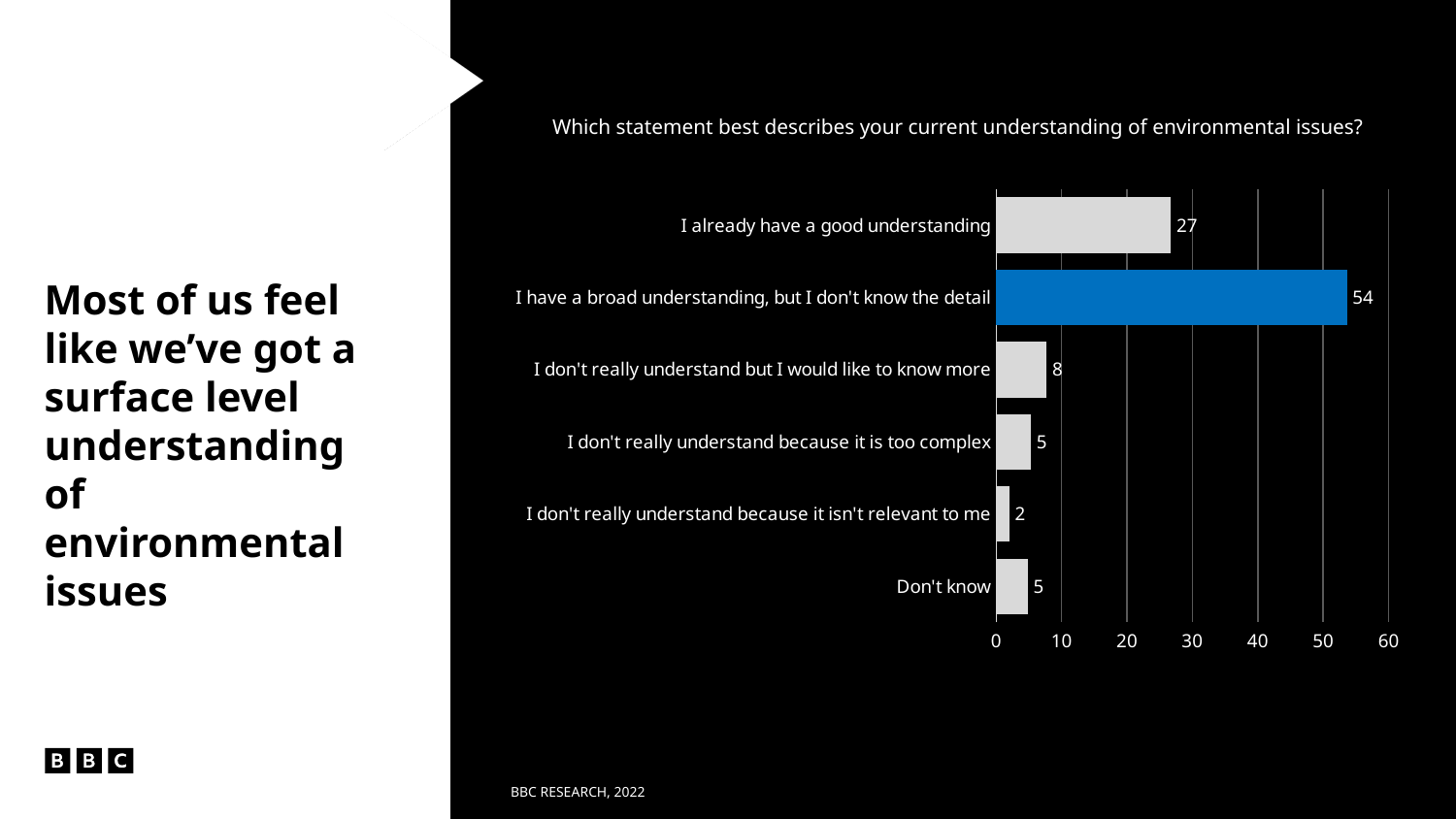
What value is shown for "Don't know"? 5 What kind of chart is shown on the slide? bar chart Is the value for "I already have a good understanding" greater or less than 30? less What value is shown for "I don't really understand because it isn't relevant to me"? 2 How many statements (categories) are shown in the chart? 6 Which bar is highlighted in blue rather than grey? I have a broad understanding, but I don't know the detail What is the difference between the values for "I have a broad understanding, but I don't know the detail" and "I already have a good understanding"? 27 Which statement has the highest value? I have a broad understanding, but I don't know the detail Which is larger: the value for "I don't really understand but I would like to know more" or the value for "I don't really understand because it is too complex"? I don't really understand but I would like to know more What value is shown for "I have a broad understanding, but I don't know the detail"? 54 What value is shown for "I already have a good understanding"? 27 Which statement has the lowest value? I don't really understand because it isn't relevant to me